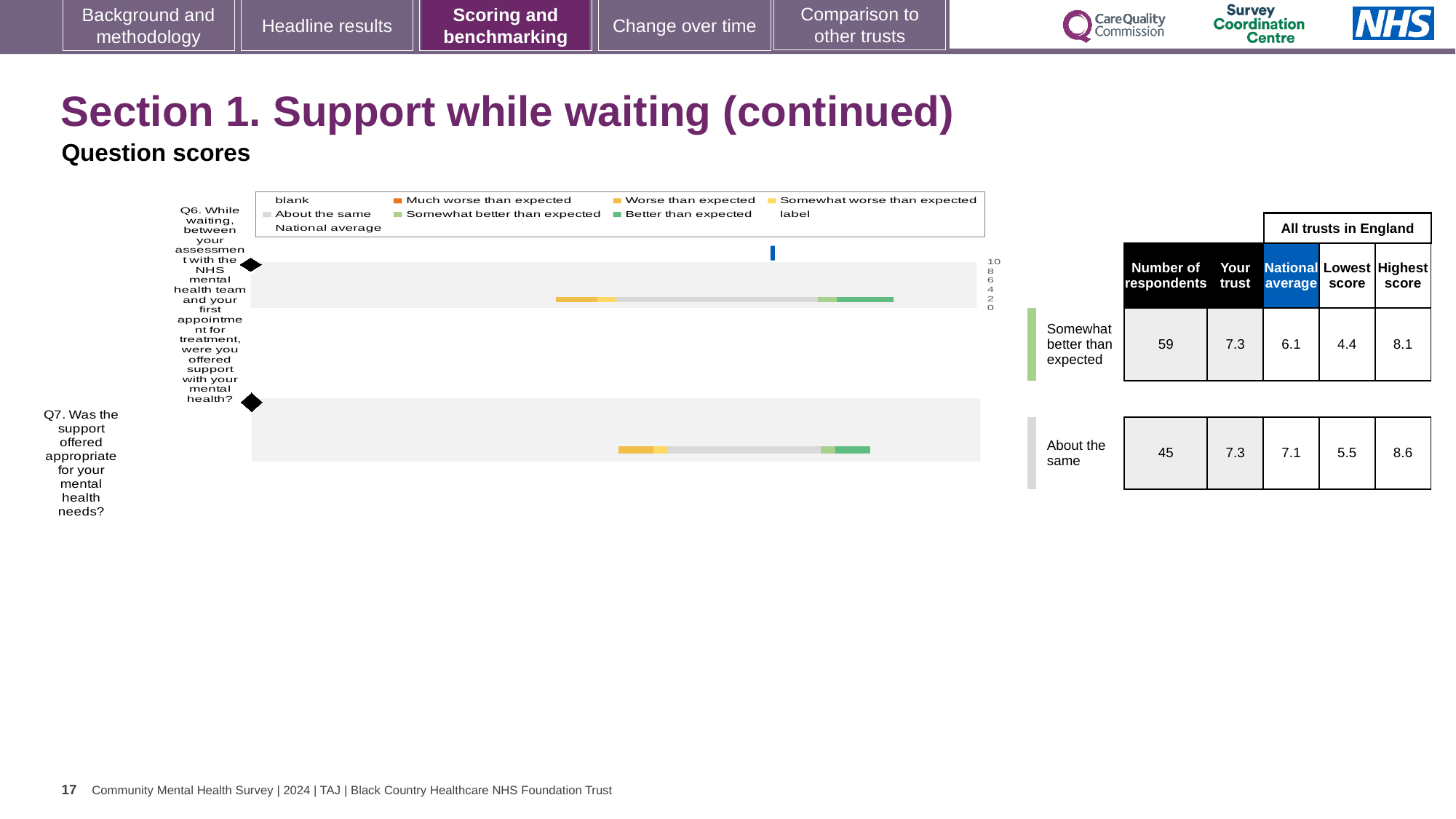
What is the highest score among all trusts in England for Q7? 8.6 What benchmark category is given for Q6? Somewhat better than expected What is the difference between the trust score and the national average for Q6? 1.2 How many questions (categories) are plotted in the chart? 2 How many entries does the chart legend list? 9 What kind of chart is shown on the slide? bar chart How many respondents answered Q6? 59 What is the national average score for Q7 (was the support offered appropriate for your mental health needs)? 7.1 How many respondents answered Q7? 45 What is the lowest score among all trusts in England for Q6? 4.4 Which question has the higher national average, Q6 or Q7? Q7 What is the 'Your trust' score for Q6 (support while waiting between assessment and first appointment)? 7.3